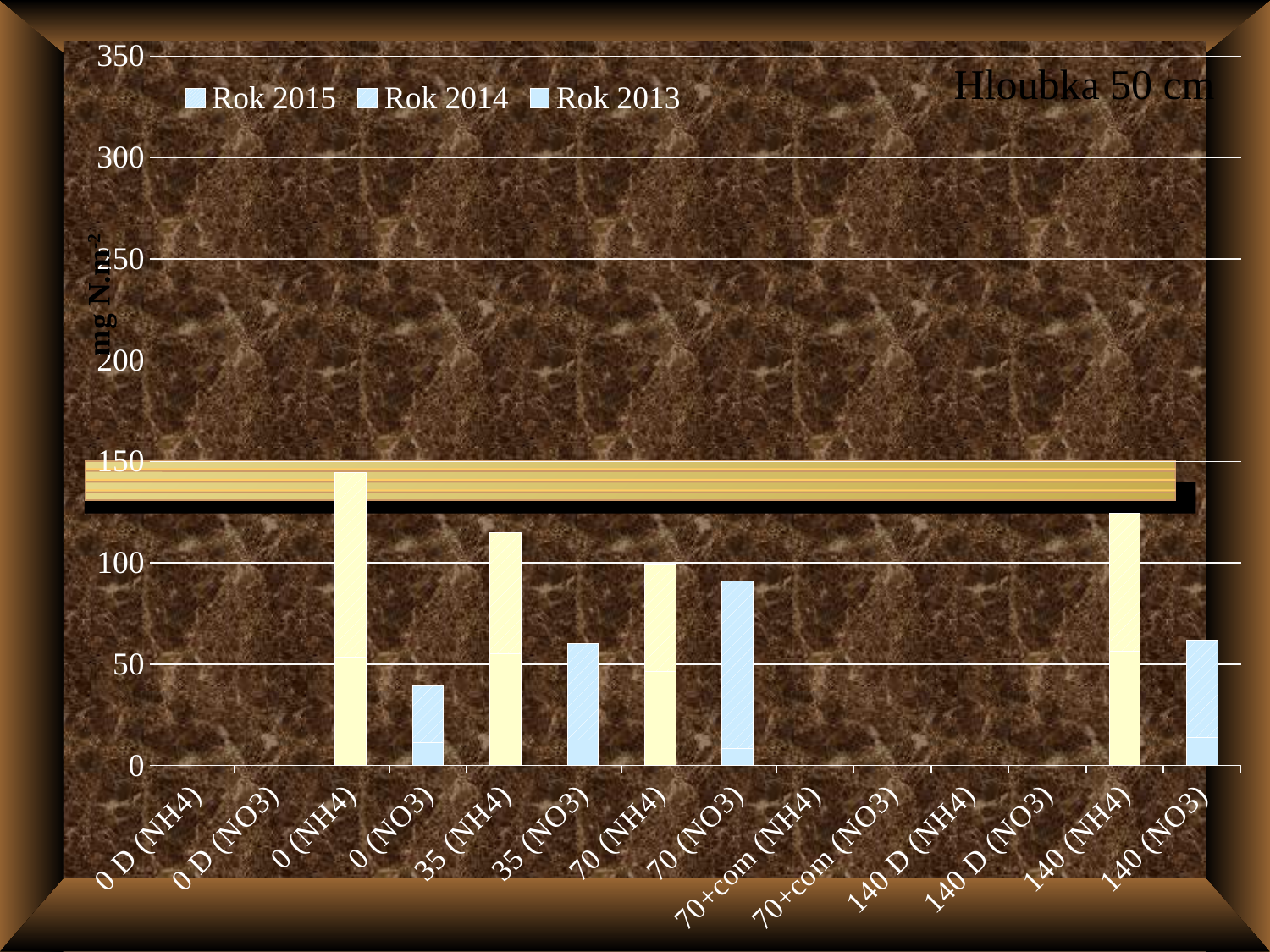
Is the value for 140 (NH4) greater or less than 100? greater Is the value for 0 (NH4) greater or less than 100? greater Which category has the tallest bar? 0 (NH4) Is the value for 0 (NO3) greater or less than 50? less How many series does the legend list? 3 Which is larger, the bar for 0 (NO3) or the bar for 70 (NO3)? 70 (NO3) What is the highest value shown on the y axis? 350 Which is larger, the bar for 35 (NH4) or the bar for 70 (NH4)? 35 (NH4) What is the title shown in the top right corner of the chart? Hloubka 50 cm What kind of chart is shown on the slide? bar chart How many categories are shown on the x axis? 14